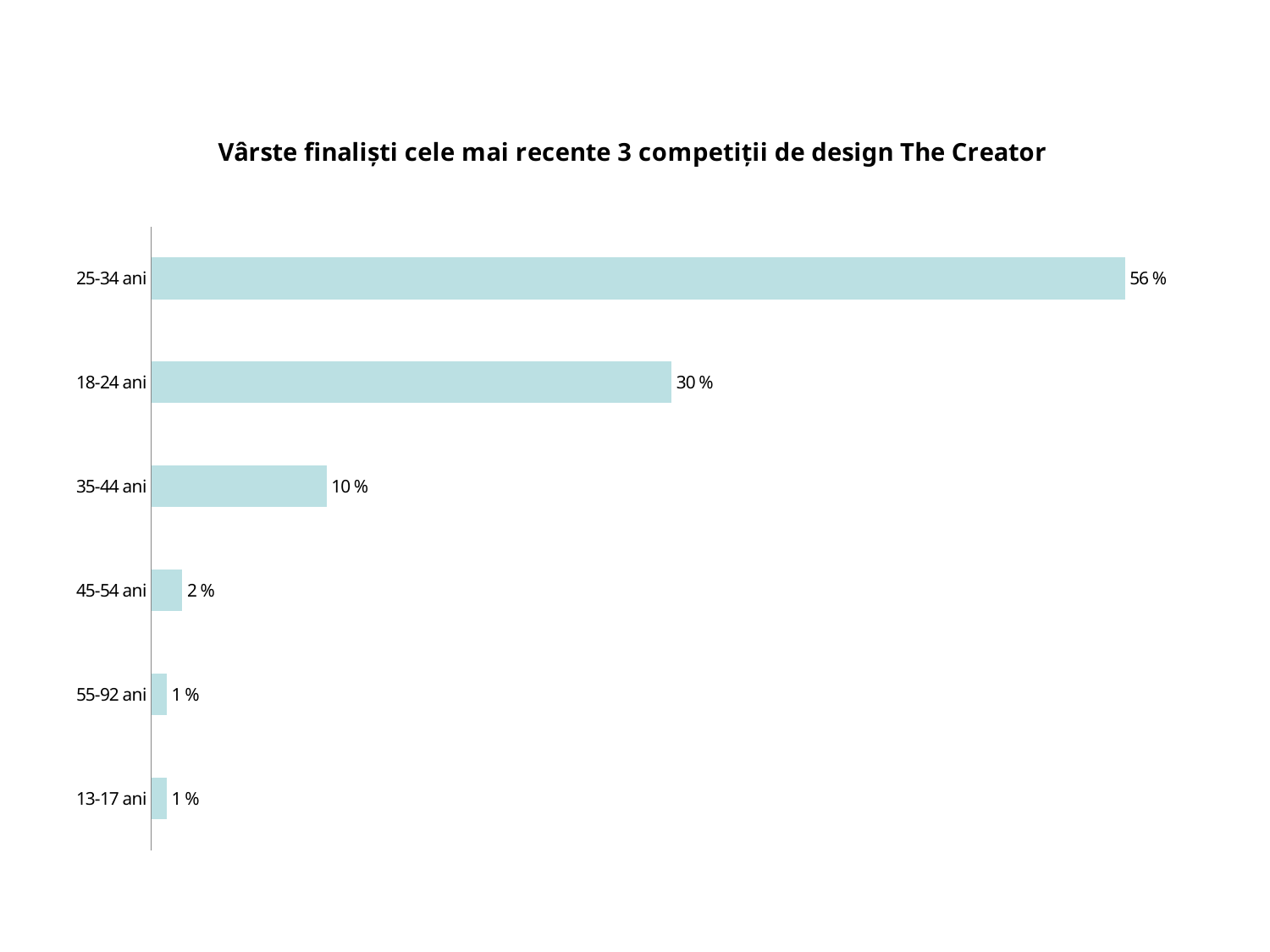
Which is larger, the value for 35-44 ani or the value for 45-54 ani? 35-44 ani What is the difference between the values for 18-24 ani and 35-44 ani? 20 % What is the difference between the values for 25-34 ani and 18-24 ani? 26 % What is the value for the 25-34 ani category? 56 % What kind of chart is shown on the slide? Bar chart What is the value for the 35-44 ani category? 10 % What is the value for the 45-54 ani category? 2 % What is the value for the 55-92 ani category? 1 % How many age categories are shown in the chart? 6 Which age category has the highest value? 25-34 ani What is the title of the chart? Vârste finaliști cele mai recente 3 competiții de design The Creator What is the value for the 18-24 ani category? 30 %